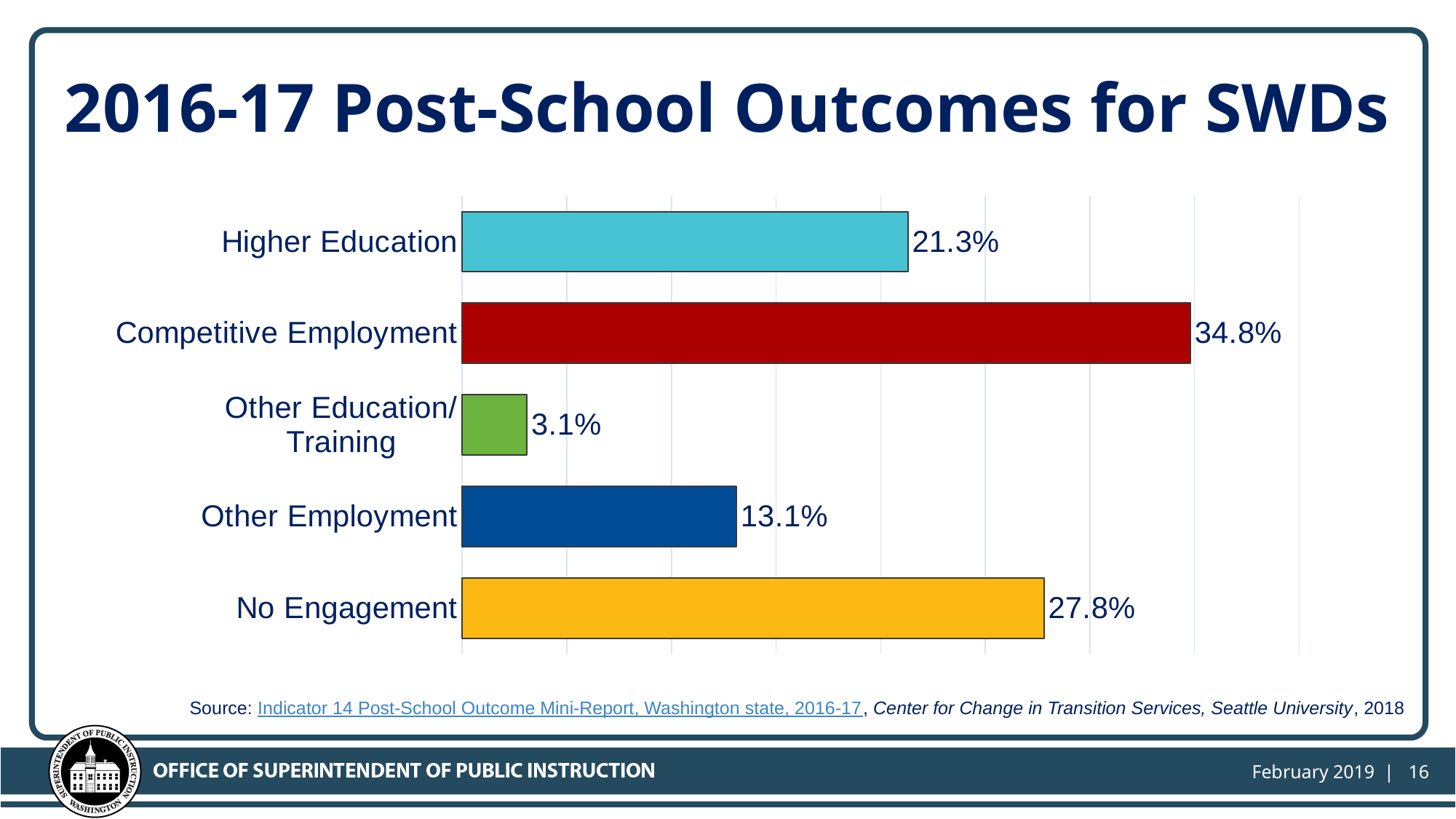
What is the value for Other Employment? 13.1% What kind of chart is shown on the slide? Bar chart What is the value for No Engagement? 27.8% How many categories are shown in the chart? 5 Which is larger, Higher Education or Other Employment? Higher Education Which category has the highest value? Competitive Employment What is the value for Other Education/Training? 3.1% What colour is the bar for Competitive Employment? Red Which category has the lowest value? Other Education/Training What is the value for Higher Education? 21.3% What is the difference between Competitive Employment and No Engagement? 7.0% What is the value for Competitive Employment? 34.8%